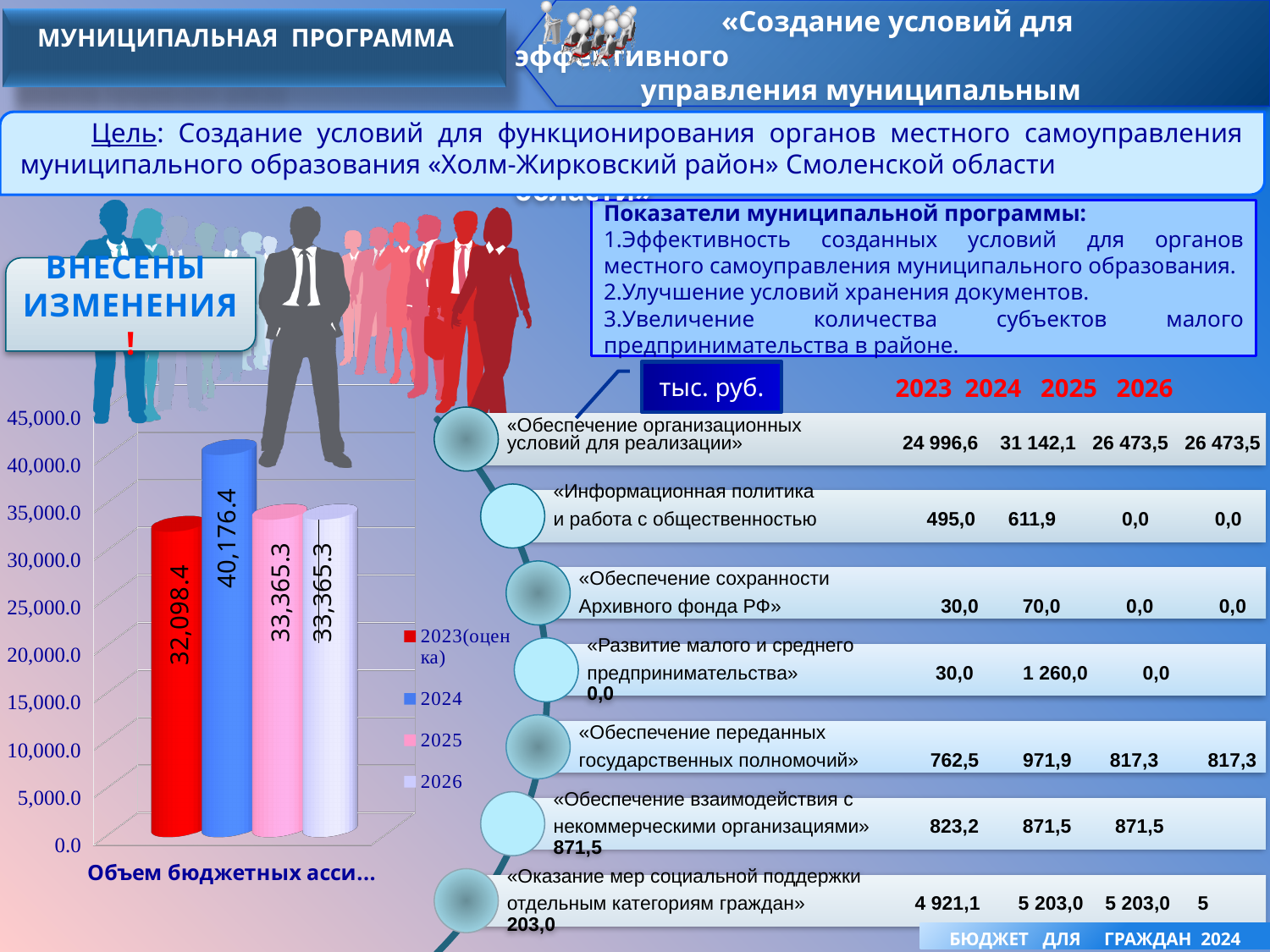
How many series does the chart legend list? 4 Which series has the lowest bar in the chart? 2023(оценка) Which is larger, the 2024 bar or the 2026 bar? 2024 What colour is the 2023(оценка) bar in the chart? red Is the value for 2024 greater or less than 35,000.0? greater Which series has the highest bar in the chart? 2024 What is the value of the 2024 bar in the chart? 40,176.4 What kind of chart is shown on the slide? bar chart What is the value of the 2025 bar in the chart? 33,365.3 What is the value of the 2023(оценка) bar in the chart? 32,098.4 What is the difference between the 2024 bar and the 2023(оценка) bar? 8,078.0 What is the difference between the 2025 bar and the 2023(оценка) bar? 1,266.9